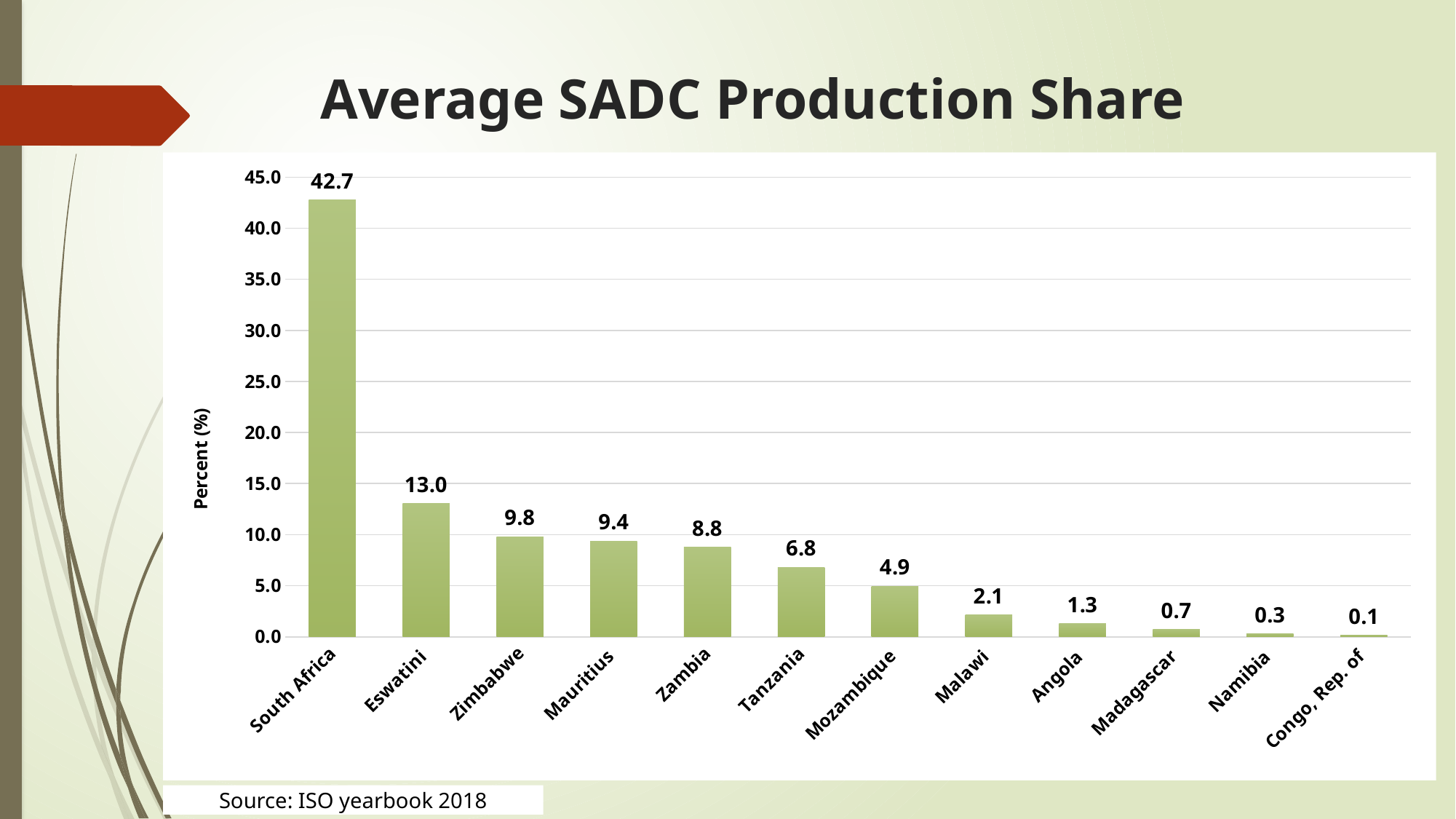
What is the difference between the values for South Africa and Eswatini? 29.7 Which country has the highest production share? South Africa What kind of chart is shown on the slide? Bar chart What is the value shown for Zambia? 8.8 What is the average SADC production share for South Africa? 42.7 What is the label of the vertical axis? Percent (%) Which country has the lowest production share? Congo, Rep. of Which has a larger production share, Tanzania or Malawi? Tanzania Is the value for Eswatini greater or less than 10.0? greater What is the difference between the values for Zimbabwe and Mauritius? 0.4 How many countries are shown on the chart? 12 What is the value shown for Mozambique? 4.9